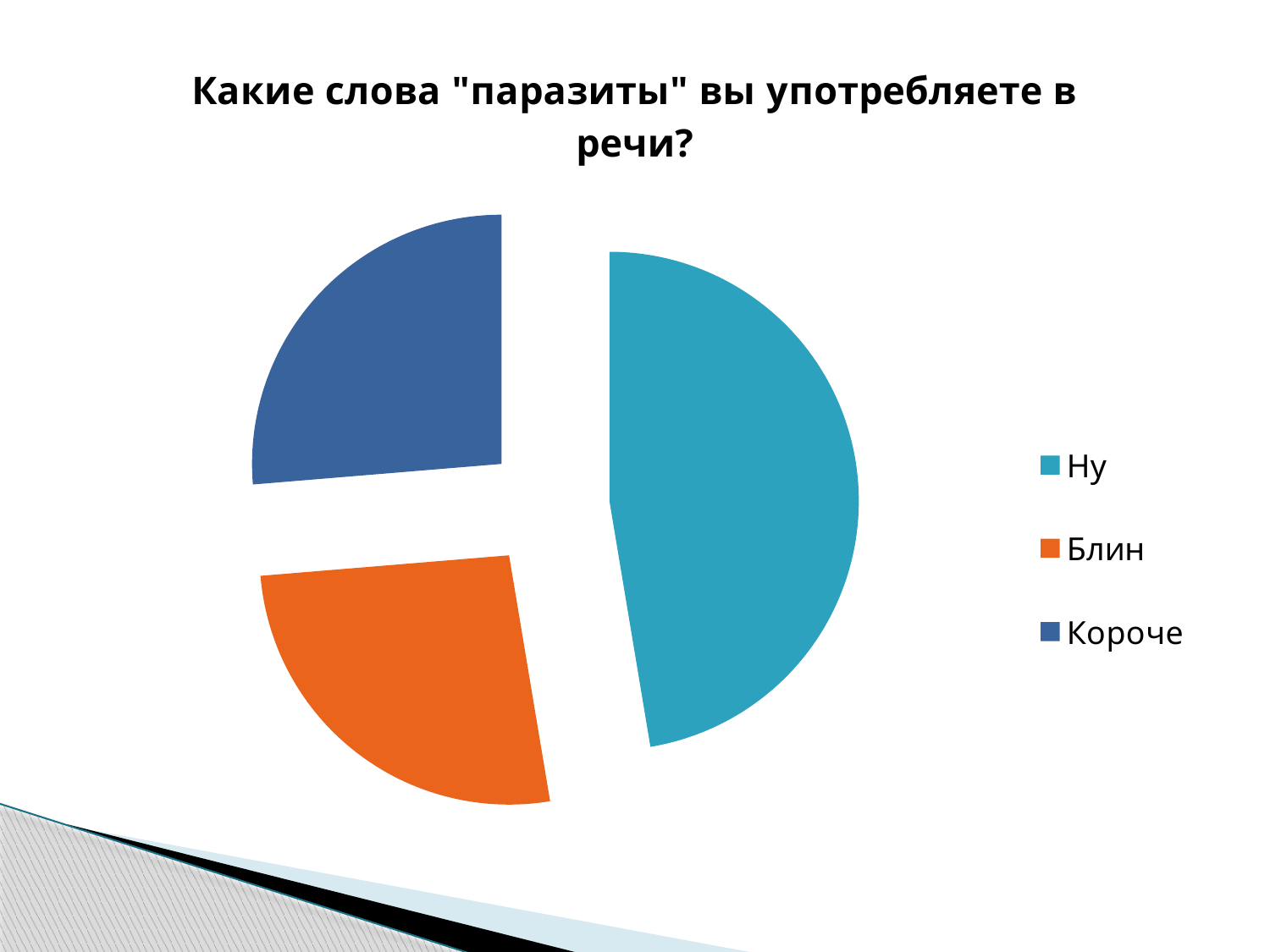
What is the title of the chart? Какие слова "паразиты" вы употребляете в речи? What kind of chart is shown on the slide? pie chart How many entries does the legend list? 3 Which category has the largest slice of the pie? Ну How many slices does the pie chart have? 3 Which category is shown in orange in the pie chart? Блин Which slice is larger, Ну or Короче? Ну Which slice is larger, Ну or Блин? Ну